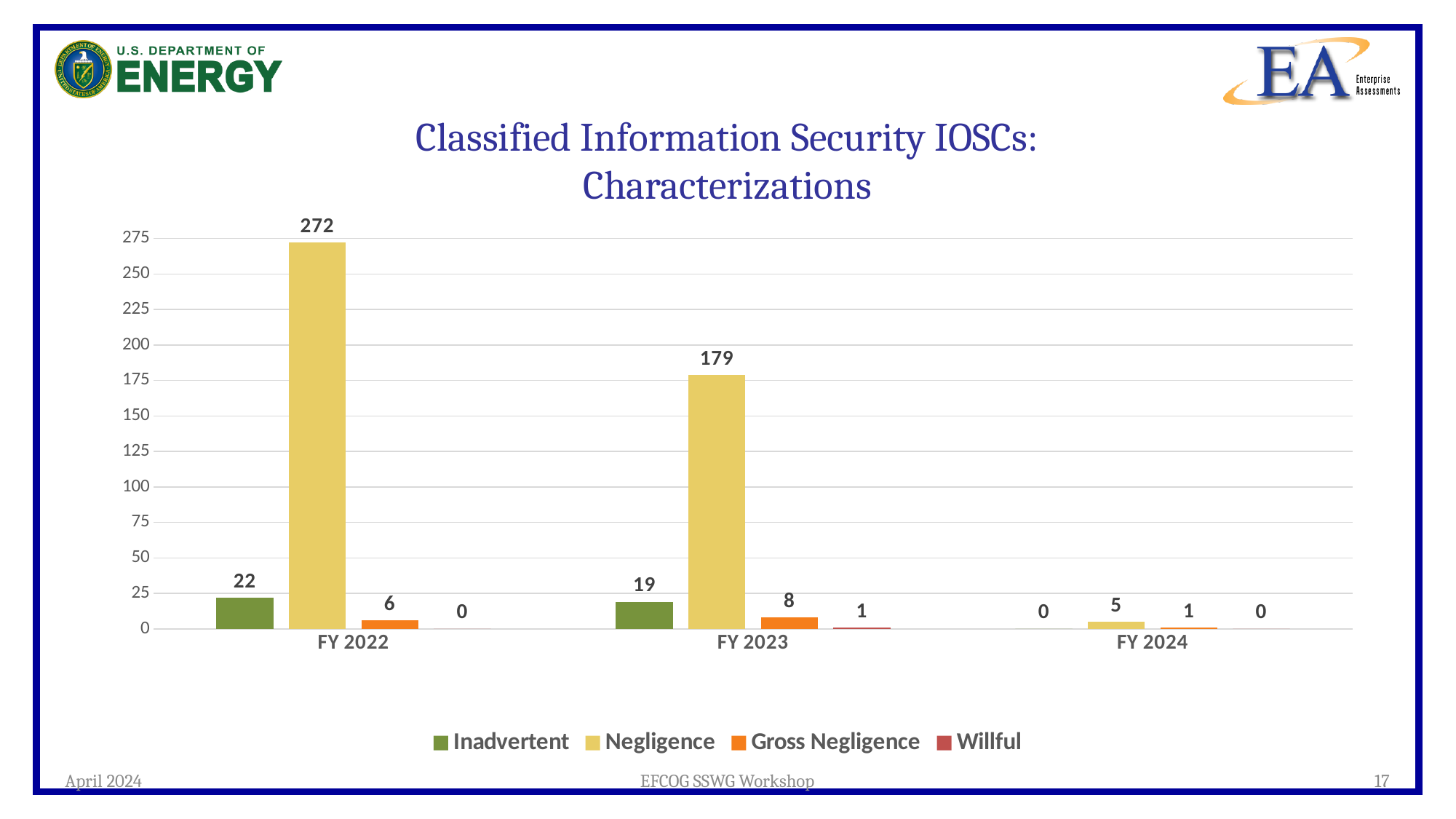
In which fiscal year is the Negligence value highest? FY 2022 Which is larger, the Gross Negligence value for FY 2022 or for FY 2023? FY 2023 How many fiscal years are shown on the x axis? 3 How many series does the legend list? 4 What is the difference between the Negligence values for FY 2022 and FY 2023? 93 Does the Negligence value rise or fall from FY 2022 to FY 2024? Fall What is the Willful value for FY 2023? 1 What is the Negligence value for FY 2022? 272 What kind of chart is shown on the slide? Bar chart What is the Gross Negligence value for FY 2024? 1 In which fiscal year is the Negligence value lowest? FY 2024 What is the Inadvertent value for FY 2023? 19